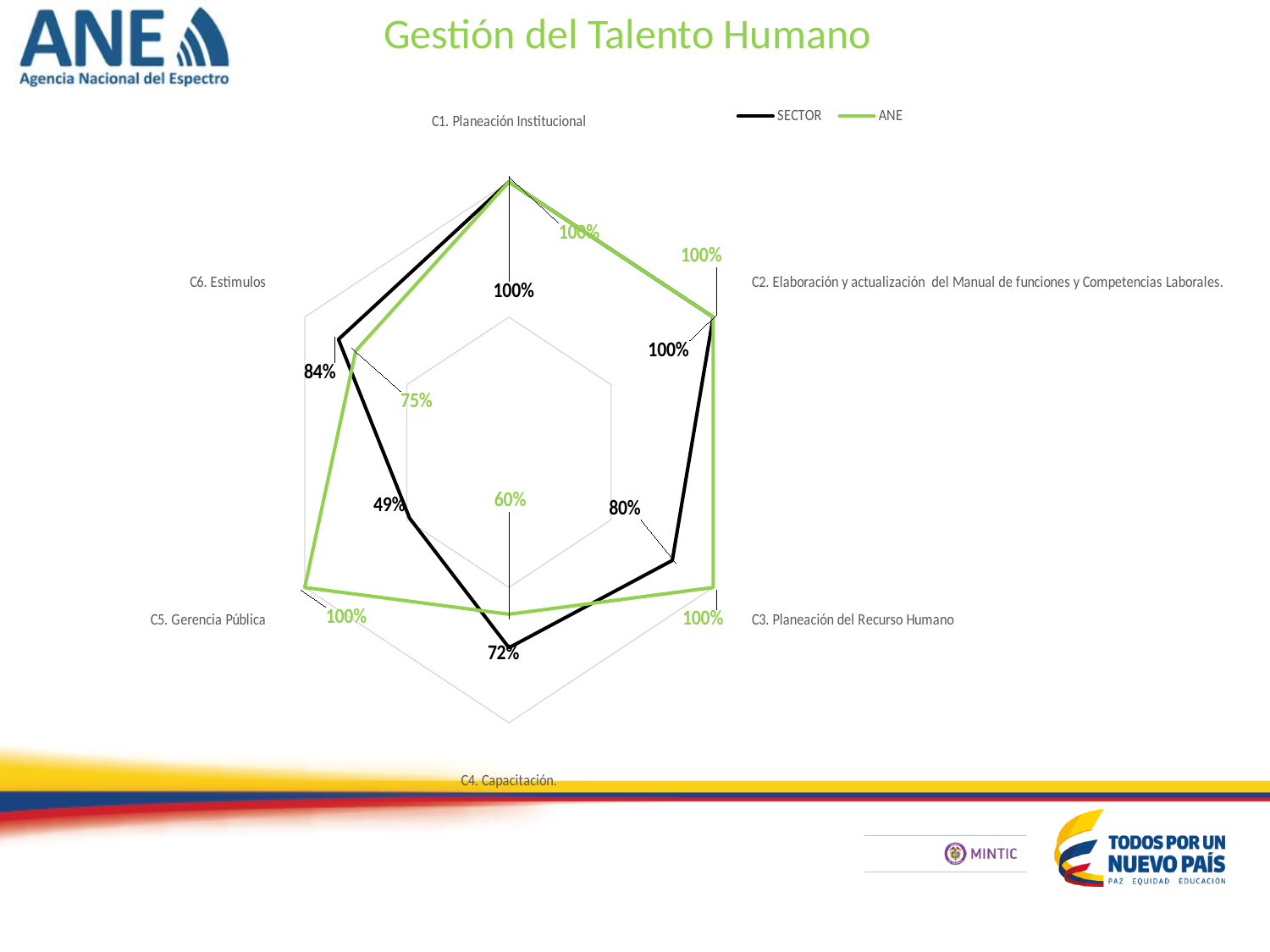
What is the SECTOR value for C4. Capacitación? 72% Which category has the lowest SECTOR value? C5. Gerencia Pública What is the SECTOR value for C5. Gerencia Pública? 49% What is the ANE value for C6. Estimulos? 75% For C6. Estimulos, which series has the larger value, SECTOR or ANE? SECTOR What type of chart is shown on the slide? Radar chart What is the SECTOR value for C3. Planeación del Recurso Humano? 80% How many series does the legend list? 2 How many categories are plotted on the radar chart? 6 What is the difference between the ANE and SECTOR values for C5. Gerencia Pública? 51% Which category has the lowest ANE value? C4. Capacitación What is the ANE value for C4. Capacitación? 60%